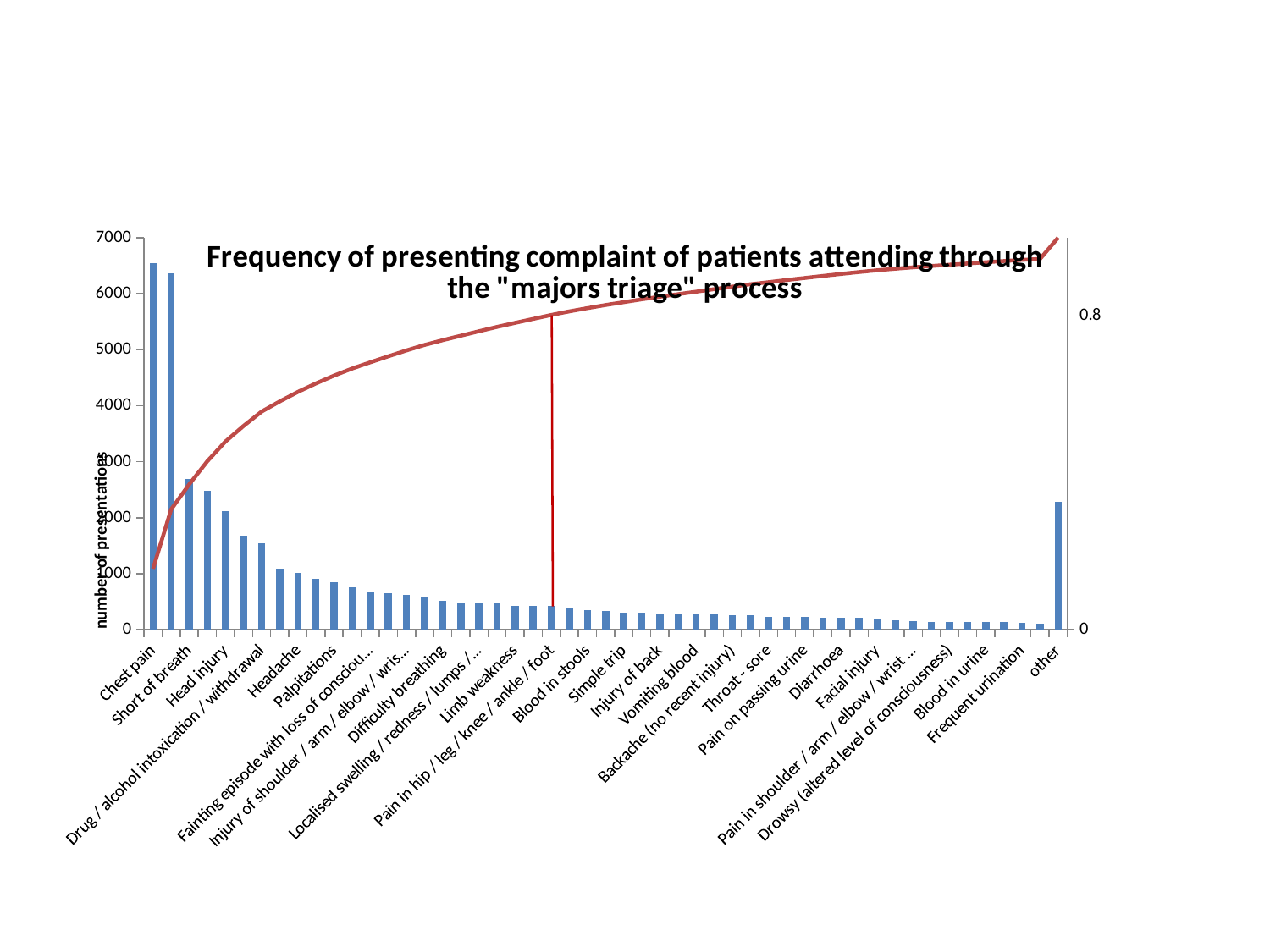
Is the value for Headache greater or less than 2000? less What is the label on the left vertical axis? number of presentations Excluding the final "other" bar, do the bar values rise or fall from left to right along the x axis? fall Is the value for Chest pain greater or less than 6000? greater Is the value for Diarrhoea greater or less than 1000? less Which has more presentations, Chest pain or other? Chest pain What is the title of the chart? Frequency of presenting complaint of patients attending through the "majors triage" process What kind of chart is used to show the number of presentations? bar chart Which has more presentations, Blood in urine or Chest pain? Chest pain